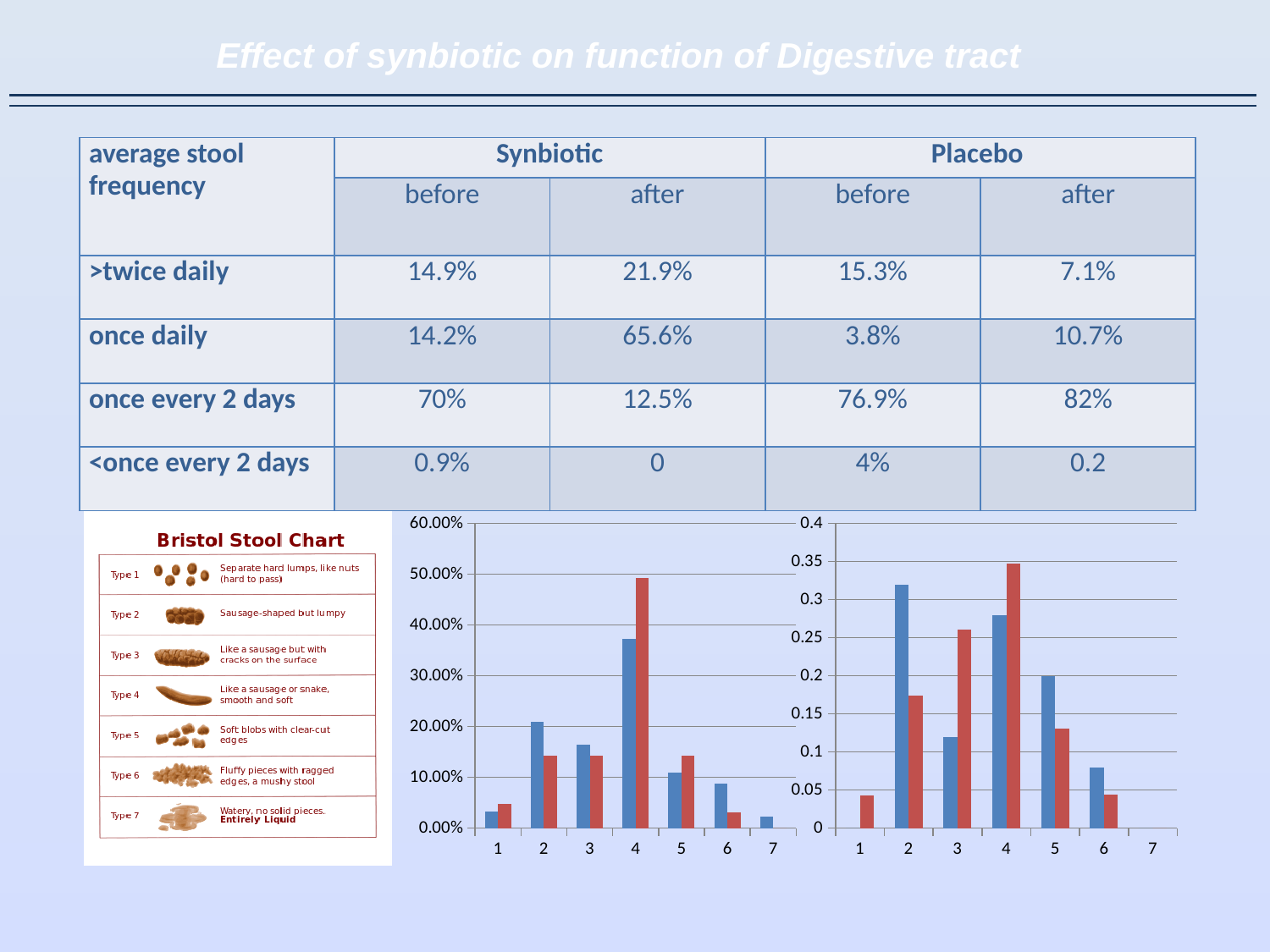
In the right chart (axis from 0 to 0.4), is the blue bar for category 5 greater or less than 0.15? greater In the left chart (percentage axis), which category has the tallest red bar? 4 What kind of chart is the left chart (with the percentage axis)? bar chart In the left chart (percentage axis), which category has the tallest blue bar? 4 In the right chart (axis from 0 to 0.4), which category has the tallest red bar? 4 In the left chart (percentage axis), how many categories are shown on the x axis? 7 In the right chart (axis from 0 to 0.4), at category 3, which bar is taller, blue or red? red In the left chart (percentage axis), is the blue bar for category 4 greater or less than 30.00%? greater In the left chart (percentage axis), is the red bar for category 4 greater or less than 40.00%? greater In the left chart (percentage axis), at category 2, which bar is taller, blue or red? blue